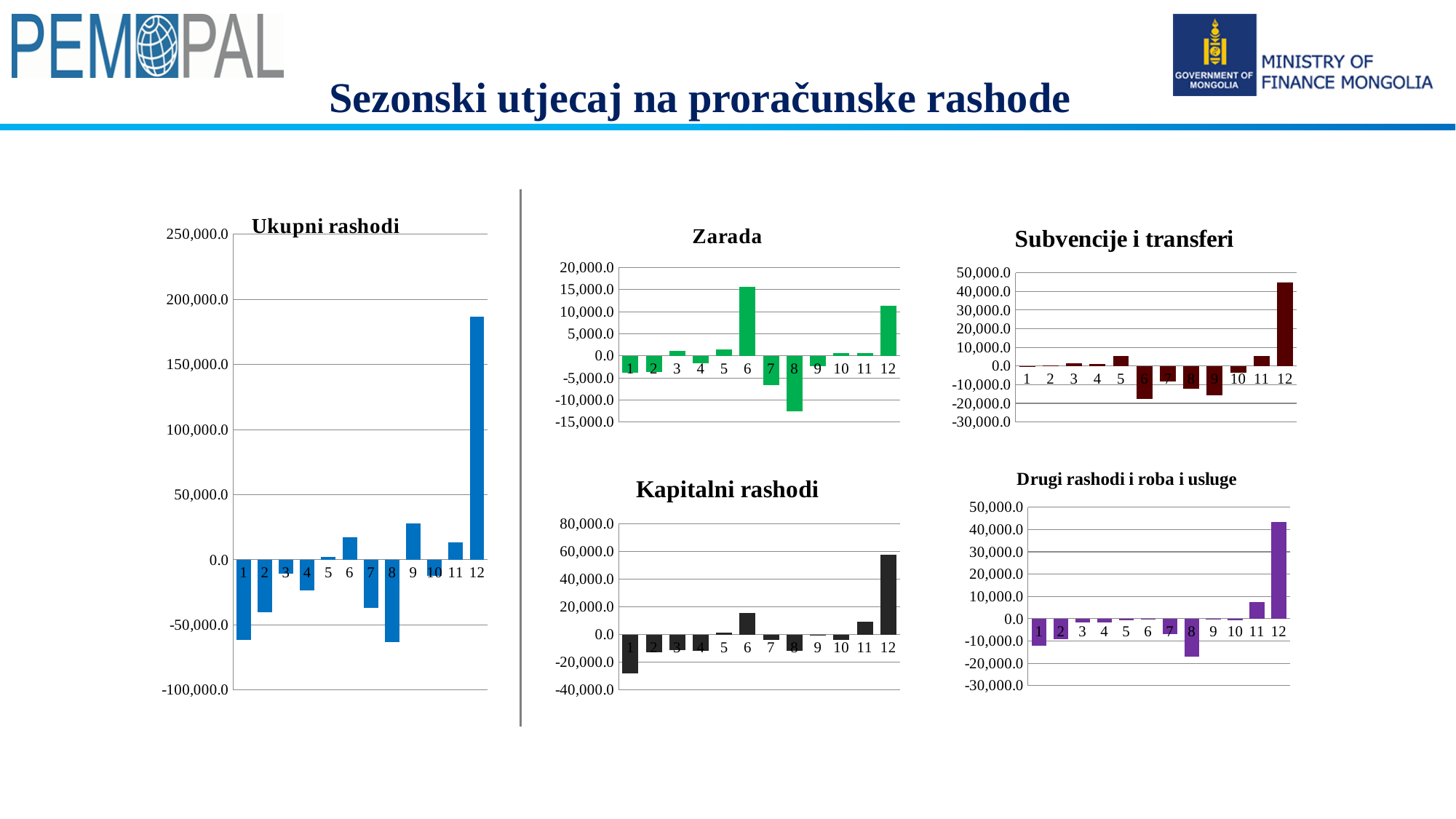
How many charts are shown on the slide? 5 In the "Ukupni rashodi" chart, how many categories are on the x axis? 12 In the "Zarada" chart, which category has the highest value? 6 In the "Zarada" chart, which category has the lowest value? 8 What type of chart is "Ukupni rashodi"? bar chart In the "Kapitalni rashodi" chart, which category has the lowest value? 1 In the "Zarada" chart, is the value for category 8 greater or less than -10,000.0? less In the "Drugi rashodi i roba i usluge" chart, is the value for category 12 greater or less than 30,000.0? greater In the "Kapitalni rashodi" chart, which is larger, the value for category 6 or category 11? 6 In the "Subvencije i transferi" chart, which category has the highest value? 12 In the "Ukupni rashodi" chart, is the value for category 12 greater or less than 150,000.0? greater In the "Ukupni rashodi" chart, which category has the highest value? 12